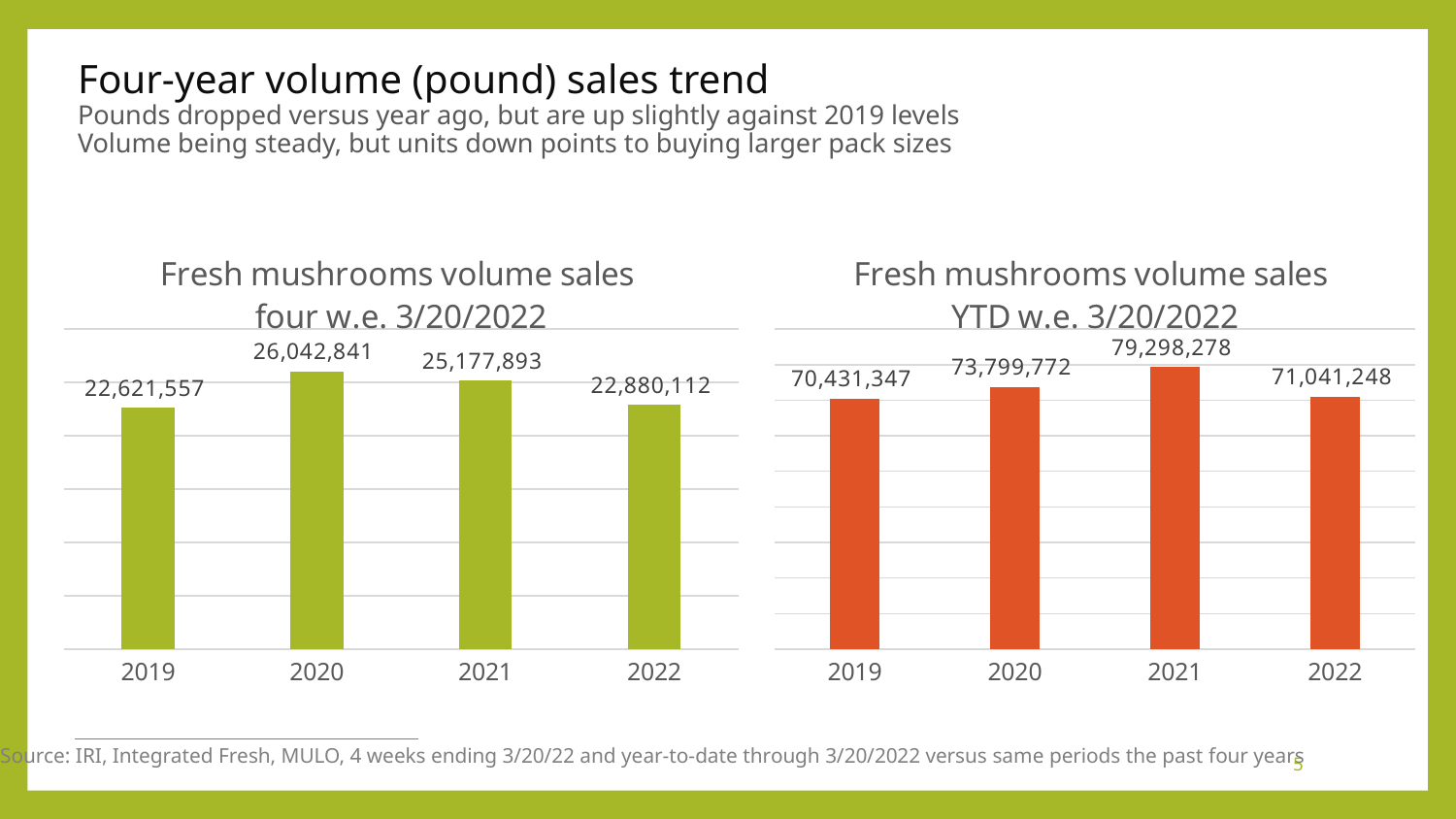
In the 'Fresh mushrooms volume sales YTD w.e. 3/20/2022' chart, what colour are the bars? Orange In the 'Fresh mushrooms volume sales four w.e. 3/20/2022' chart, what is the value for 2019? 22,621,557 In the 'Fresh mushrooms volume sales YTD w.e. 3/20/2022' chart, what is the difference between the 2021 and 2022 values? 8,257,030 In the 'Fresh mushrooms volume sales four w.e. 3/20/2022' chart, what is the difference between the 2020 and 2019 values? 3,421,284 In the 'Fresh mushrooms volume sales YTD w.e. 3/20/2022' chart, which year has the highest value? 2021 In the 'Fresh mushrooms volume sales YTD w.e. 3/20/2022' chart, which year has the lowest value? 2019 In the 'Fresh mushrooms volume sales four w.e. 3/20/2022' chart, which is larger, the value for 2021 or the value for 2022? 2021 How many years are shown in the 'Fresh mushrooms volume sales four w.e. 3/20/2022' chart? 4 In the 'Fresh mushrooms volume sales four w.e. 3/20/2022' chart, which year has the highest value? 2020 In the 'Fresh mushrooms volume sales YTD w.e. 3/20/2022' chart, which is larger, the value for 2020 or the value for 2019? 2020 What type of chart is the 'Fresh mushrooms volume sales YTD w.e. 3/20/2022' chart? Bar chart In the 'Fresh mushrooms volume sales YTD w.e. 3/20/2022' chart, what is the value for 2022? 71,041,248